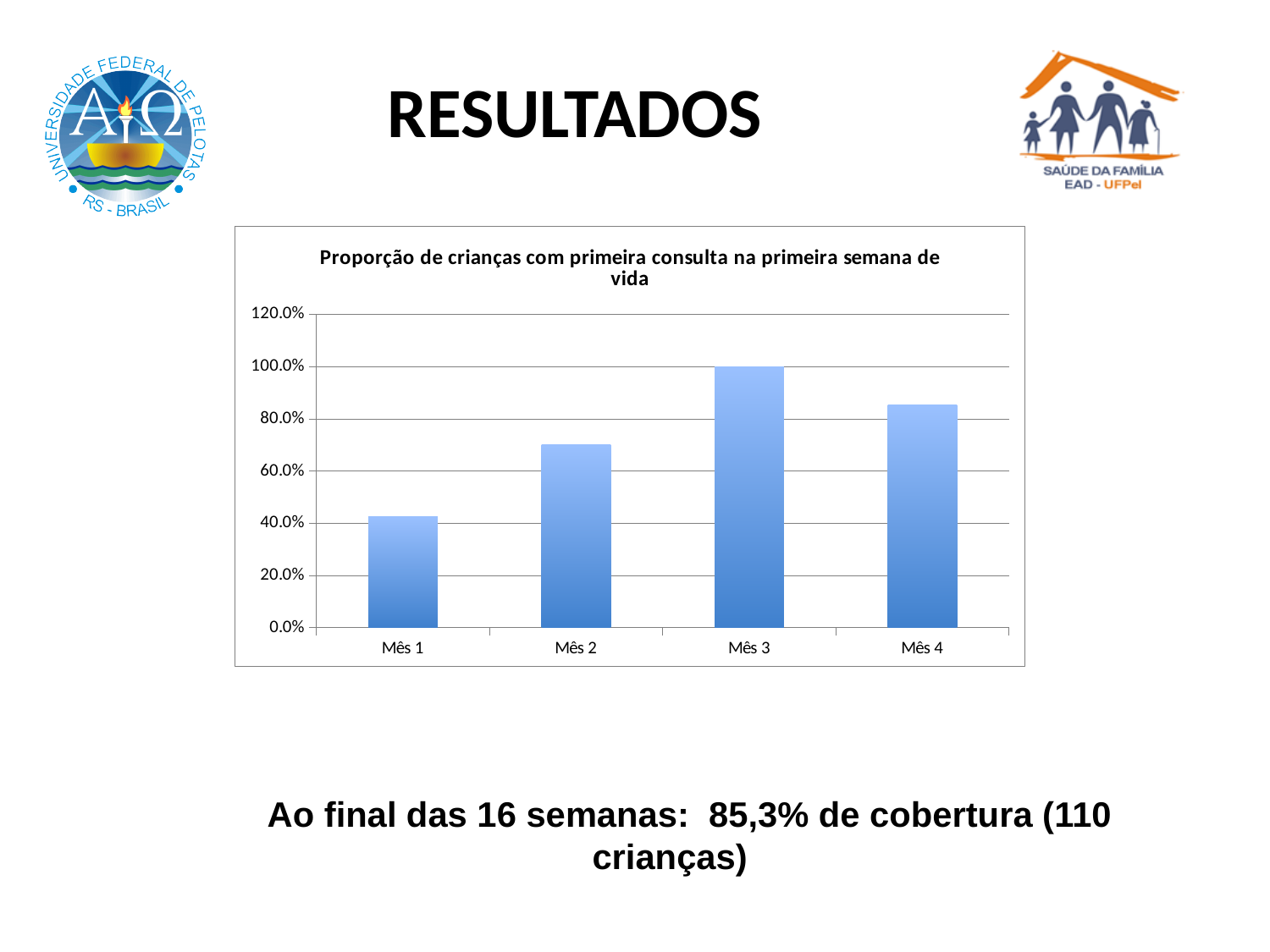
What is the title of the chart? Proporção de crianças com primeira consulta na primeira semana de vida Which is larger, the value for Mês 1 or the value for Mês 2? Mês 2 Which is larger, the value for Mês 2 or the value for Mês 4? Mês 4 Do the values rise or fall from Mês 1 to Mês 3? rise How many months (categories) are plotted on the x axis of the chart? 4 Which month has the highest proportion in the chart? Mês 3 Is the value for Mês 4 greater or less than 100.0%? less Is the value for Mês 2 greater or less than 60.0%? greater Is the value for Mês 1 greater or less than 60.0%? less What is the value for Mês 3 in the chart? 100.0% Which month has the lowest proportion in the chart? Mês 1 What kind of chart is shown on the slide? Bar chart